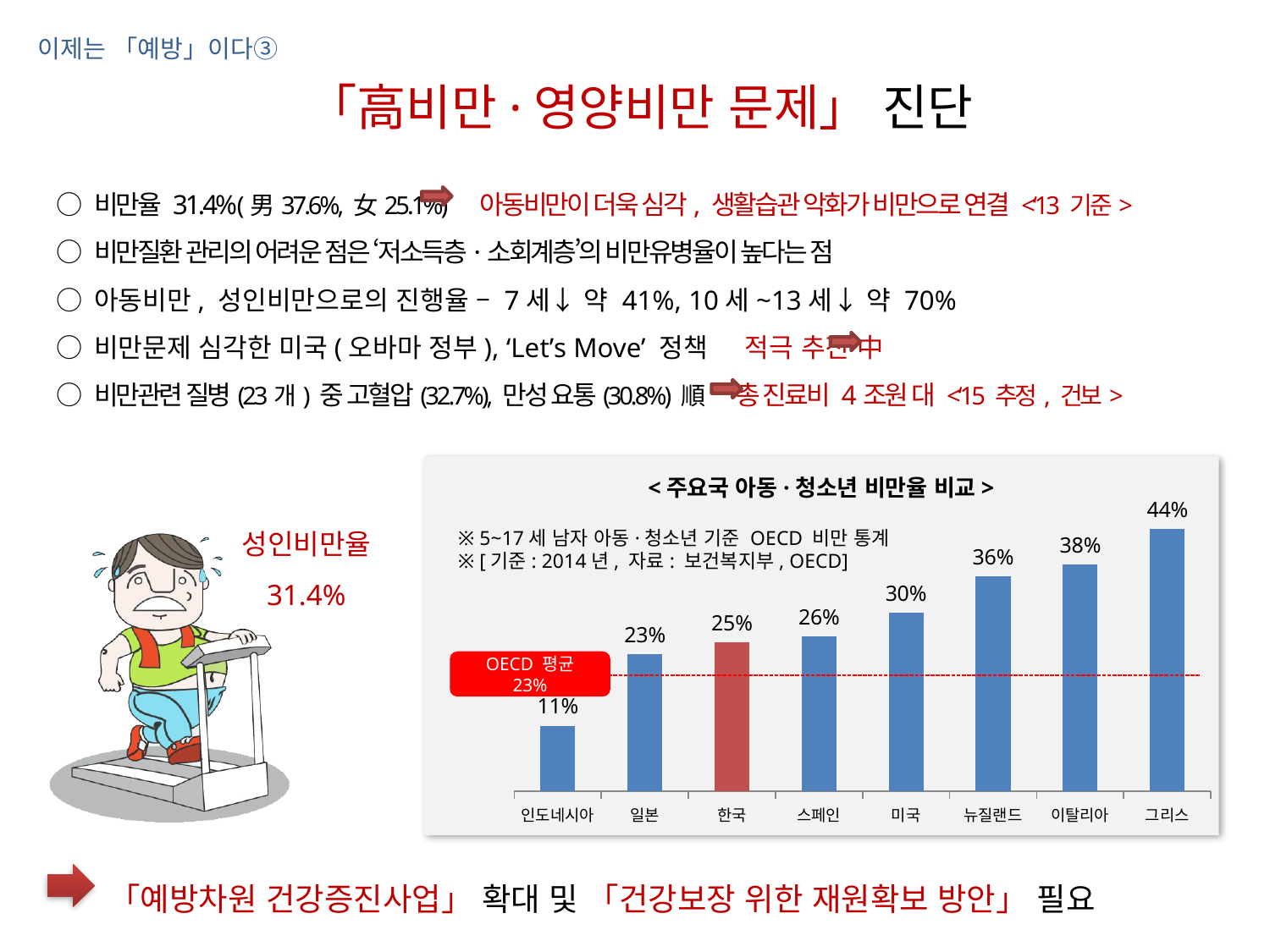
Which has a higher obesity rate, 뉴질랜드 or 스페인? 뉴질랜드 Which country has the highest obesity rate in the chart? 그리스 Which country has the lowest obesity rate in the chart? 인도네시아 What value does the chart show for 인도네시아 (Indonesia)? 11% What type of chart is used to compare the countries' obesity rates? Bar chart Do the values rise or fall from left to right across the chart? Rise What OECD average value is marked by the red dashed line in the chart? 23% How many countries are shown in the chart? 8 What value does the chart show for 그리스 (Greece)? 44% What is the difference between the obesity rates of 이탈리아 and 미국? 8% What is the difference between the obesity rates of 그리스 and 한국? 19% What is the child and adolescent obesity rate shown for 한국 (Korea) in the chart? 25%